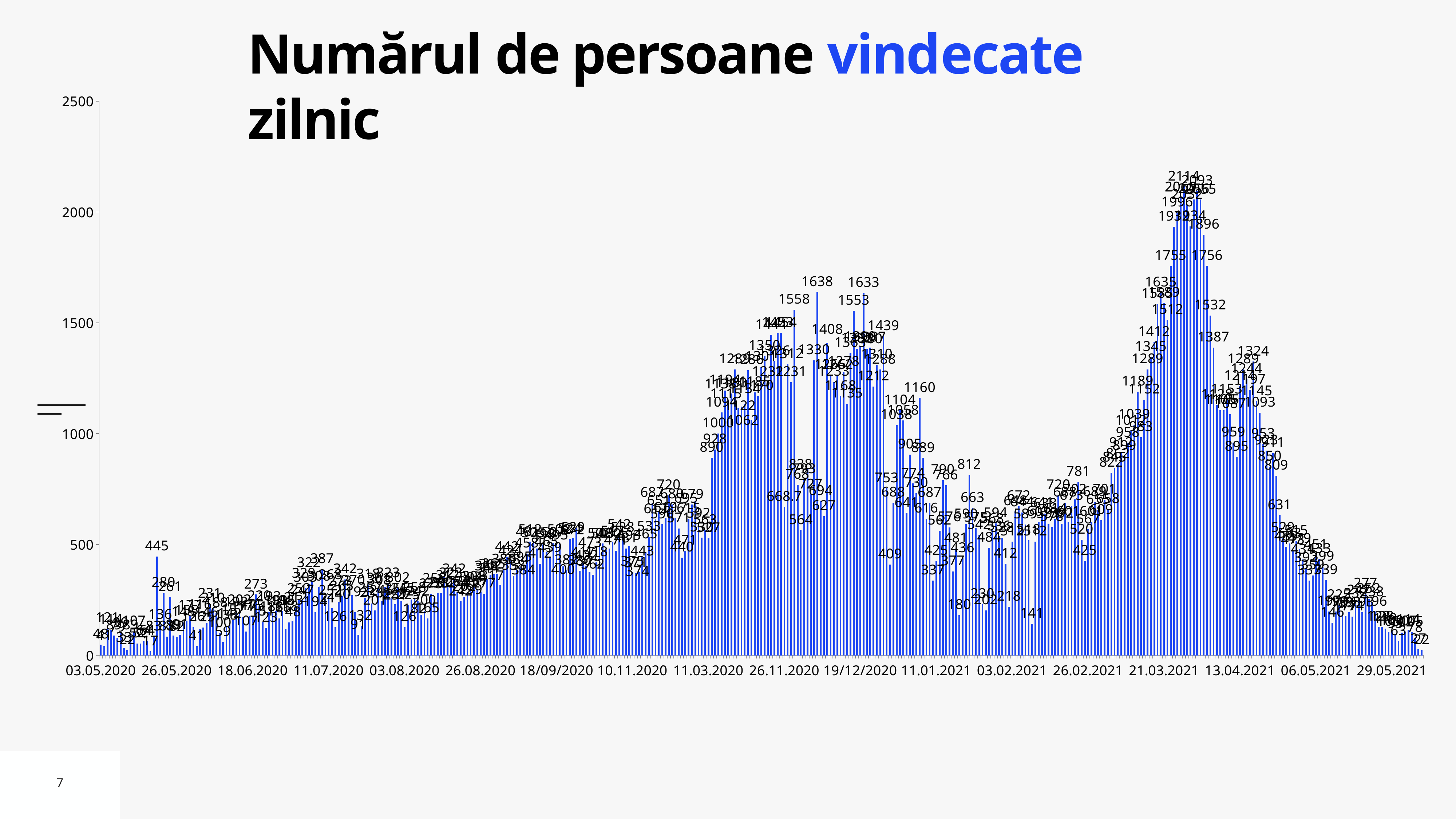
What is the last date label on the horizontal axis? 29.05.2021 Is the tallest bar in May 2020 (labeled 445) greater or less than 500? less What is the title of the chart? Numărul de persoane vindecate zilnic Is the highest bar on the chart greater or less than 2000? greater What is the first date label on the horizontal axis? 03.05.2020 Do the values rise or fall from the 13.04.2021 tick to the 29.05.2021 tick? fall What is the maximum value shown on the vertical axis? 2500 What is the difference between the overall highest labeled value (2114) and the late-November 2020 peak value (1638)? 476 What kind of chart is shown on the slide? bar chart What is the highest data label shown on the chart? 2114 What is the highest value labeled in the peak around late November 2020 (near the 26.11.2020 tick)? 1638 Which is larger: the peak value in March/April 2021 (2114) or the peak value in November 2020 (1638)? 2114